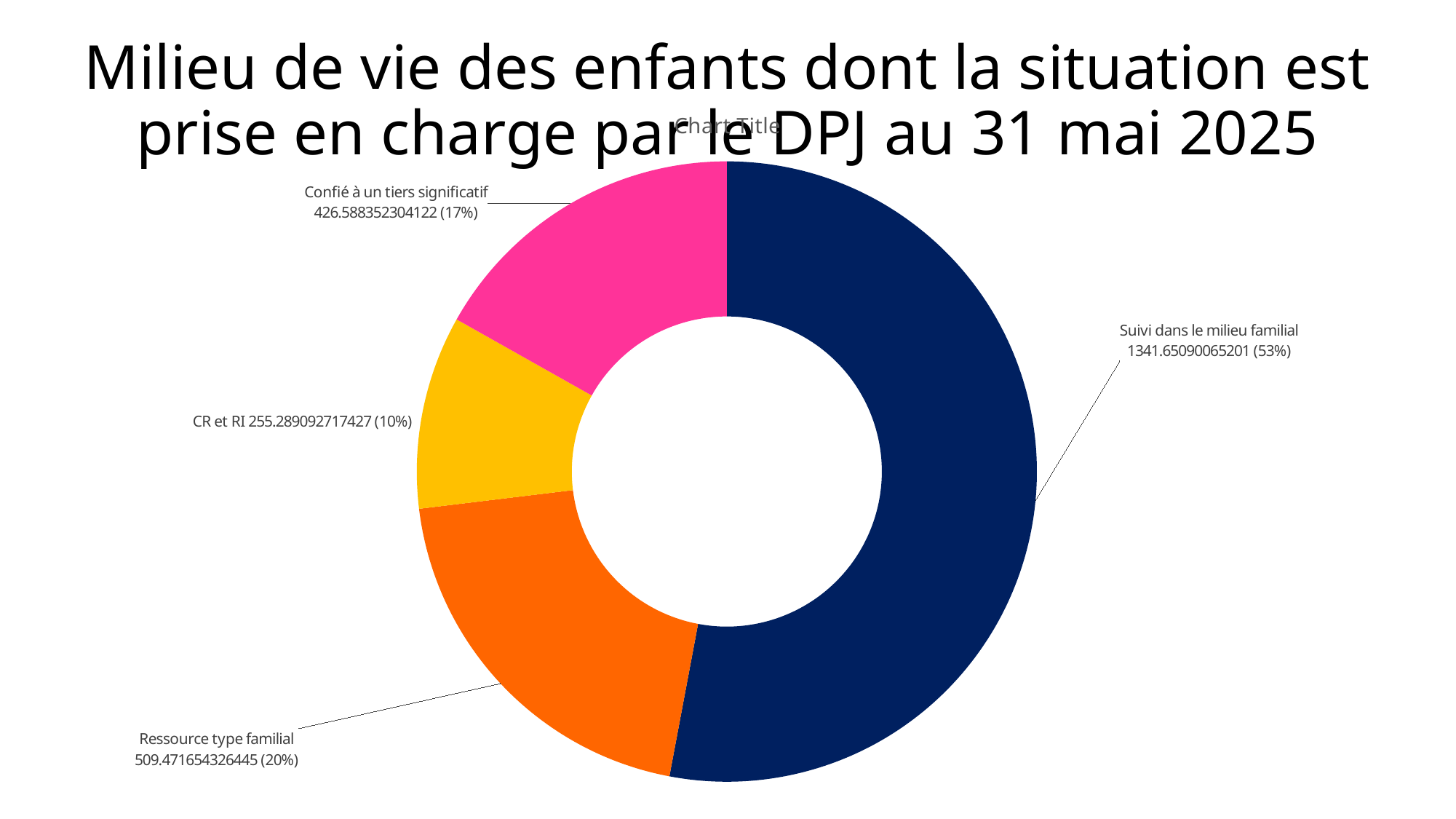
What is the difference in percentage points between the 'Suivi dans le milieu familial' share and the 'Ressource type familial' share? 33 percentage points What share of the chart does 'Confié à un tiers significatif' represent? 17% How many categories (slices) does the chart show? 4 What share of the chart does 'Suivi dans le milieu familial' represent? 53% What kind of chart is shown on the slide? doughnut (pie) chart What value is printed for 'Suivi dans le milieu familial'? 1341.65090065201 Which category has the smallest slice? CR et RI Which category has the largest slice? Suivi dans le milieu familial What value is printed for 'CR et RI'? 255.289092717427 What share of the chart does 'Ressource type familial' represent? 20% Which is larger: the slice for 'Ressource type familial' or the slice for 'Confié à un tiers significatif'? Ressource type familial